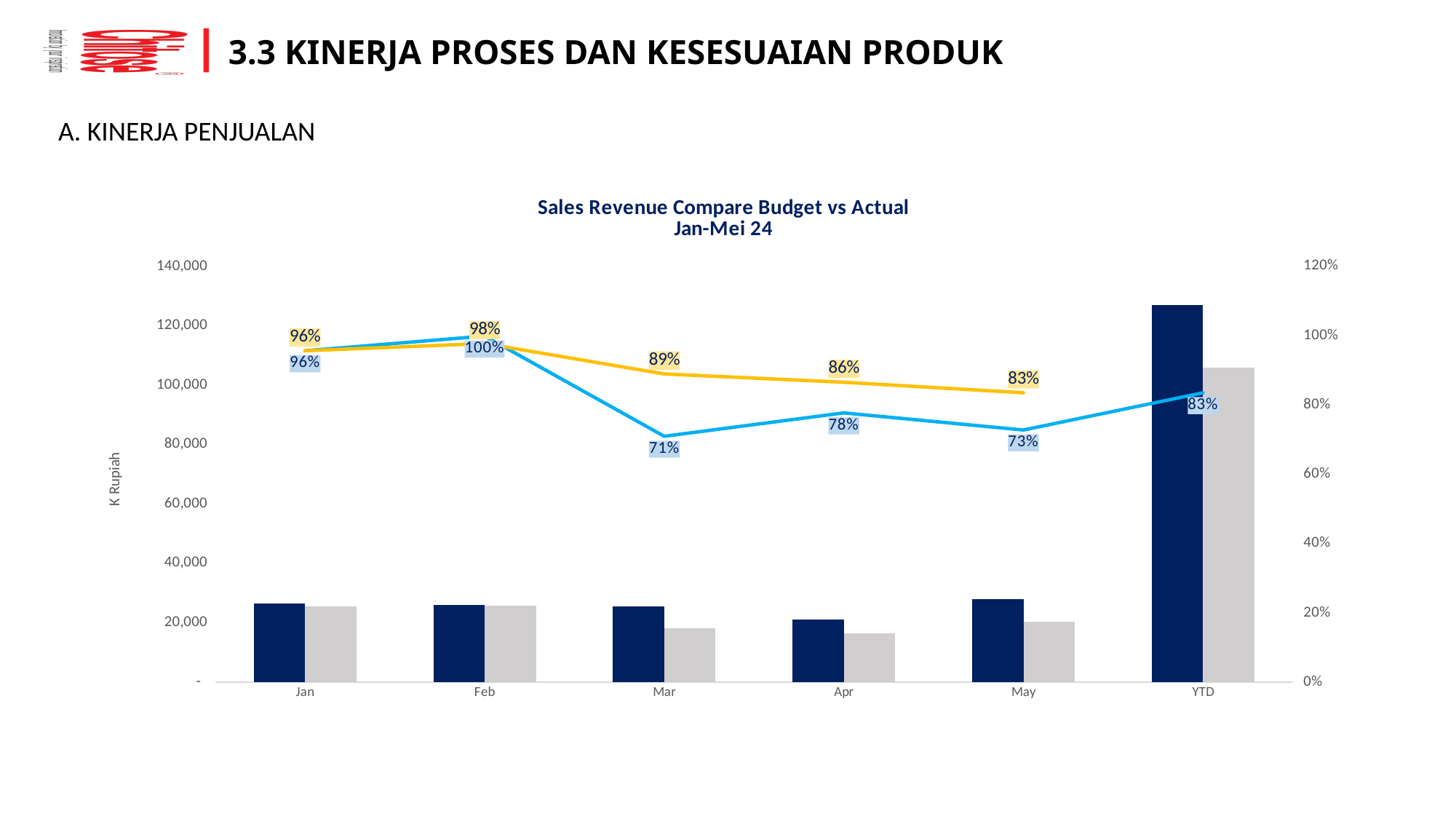
In which category does the blue line reach its highest value? Feb How many categories are shown on the x axis? 6 What is the difference between the yellow line value and the blue line value for May? 10% Does the yellow line rise or fall from Feb to May? fall In which category does the blue line reach its lowest value? Mar Is the value of the dark blue bar for YTD greater or less than 120,000? greater Which is larger for Mar, the yellow line value or the blue line value? the yellow line value Is the value of the grey bar for Apr greater or less than 20,000? less What value does the blue line show for YTD? 83% What value does the yellow line show for Apr? 86% What value does the blue line show for Mar? 71% What is the title of the chart? Sales Revenue Compare Budget vs Actual Jan-Mei 24